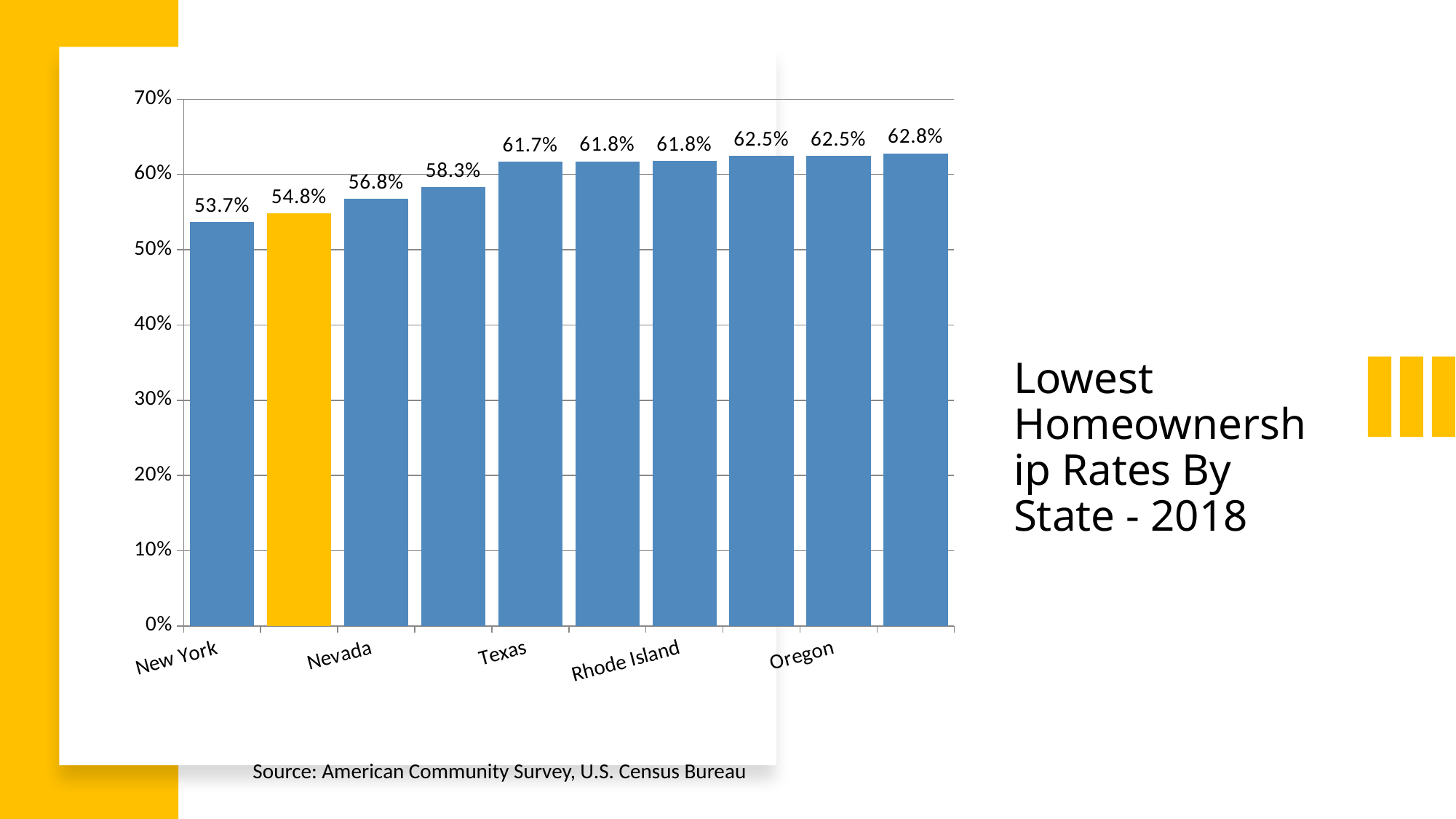
What is the homeownership rate shown for Texas? 61.7% What is the homeownership rate shown for New York? 53.7% What type of chart is shown on the slide? Bar chart What is the difference in percentage points between Nevada's and New York's homeownership rates? 3.1 percentage points Which labeled state has the lowest homeownership rate on the chart? New York Which has a higher homeownership rate, Texas or New York? Texas What is the highest value labeled on any bar in the chart? 62.8% Do the values rise or fall moving from left to right along the x axis? Rise What is the homeownership rate shown for Oregon? 62.5% How many bars are plotted in the chart? 10 What is the homeownership rate shown for Rhode Island? 61.8% What is the homeownership rate shown for Nevada? 56.8%